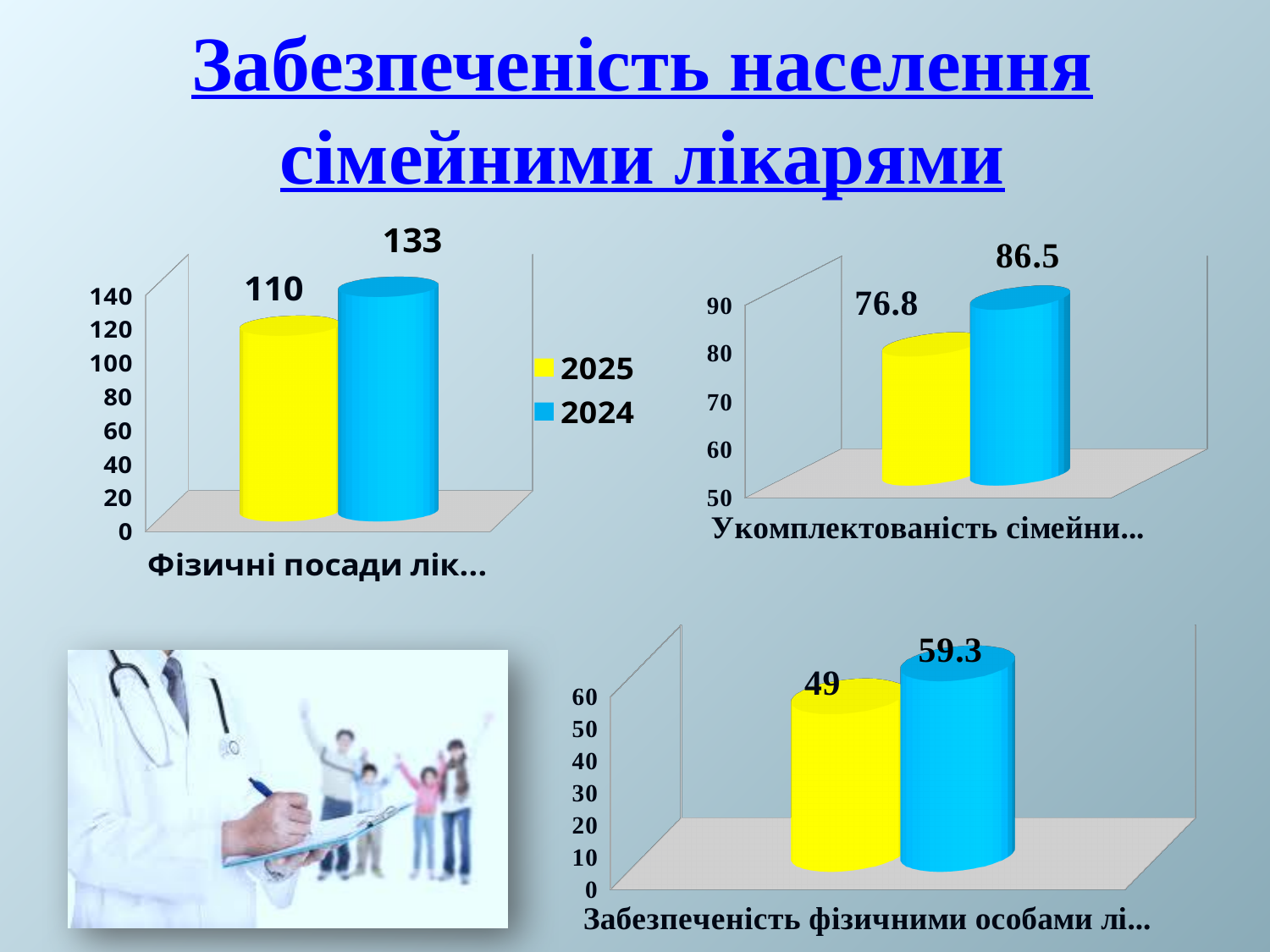
In the bottom-right chart (Забезпеченість фізичними особами лі...), what is the value of the blue bar? 59.3 How many series does the legend of the top-left chart list? 2 In the bottom-right chart (Забезпеченість фізичними особами лі...), which bar is higher, the yellow or the blue one? blue In the top-left chart (Фізичні посади лік...), what is the value for 2025? 110 In the top-left chart (Фізичні посади лік...), which year has the higher value, 2024 or 2025? 2024 What kind of chart is the bottom-right chart (Забезпеченість фізичними особами лі...)? bar chart In the top-right chart (Укомплектованість сімейни...), what is the value of the yellow bar? 76.8 In the top-left chart (Фізичні посади лік...), what is the value for 2024? 133 In the bottom-right chart (Забезпеченість фізичними особами лі...), what is the value of the yellow bar? 49 In the top-right chart (Укомплектованість сімейни...), what is the value of the blue bar? 86.5 In the top-right chart (Укомплектованість сімейни...), is the value of the yellow bar greater or less than 80? less In the top-left chart (Фізичні посади лік...), what is the difference between the 2024 and 2025 values? 23